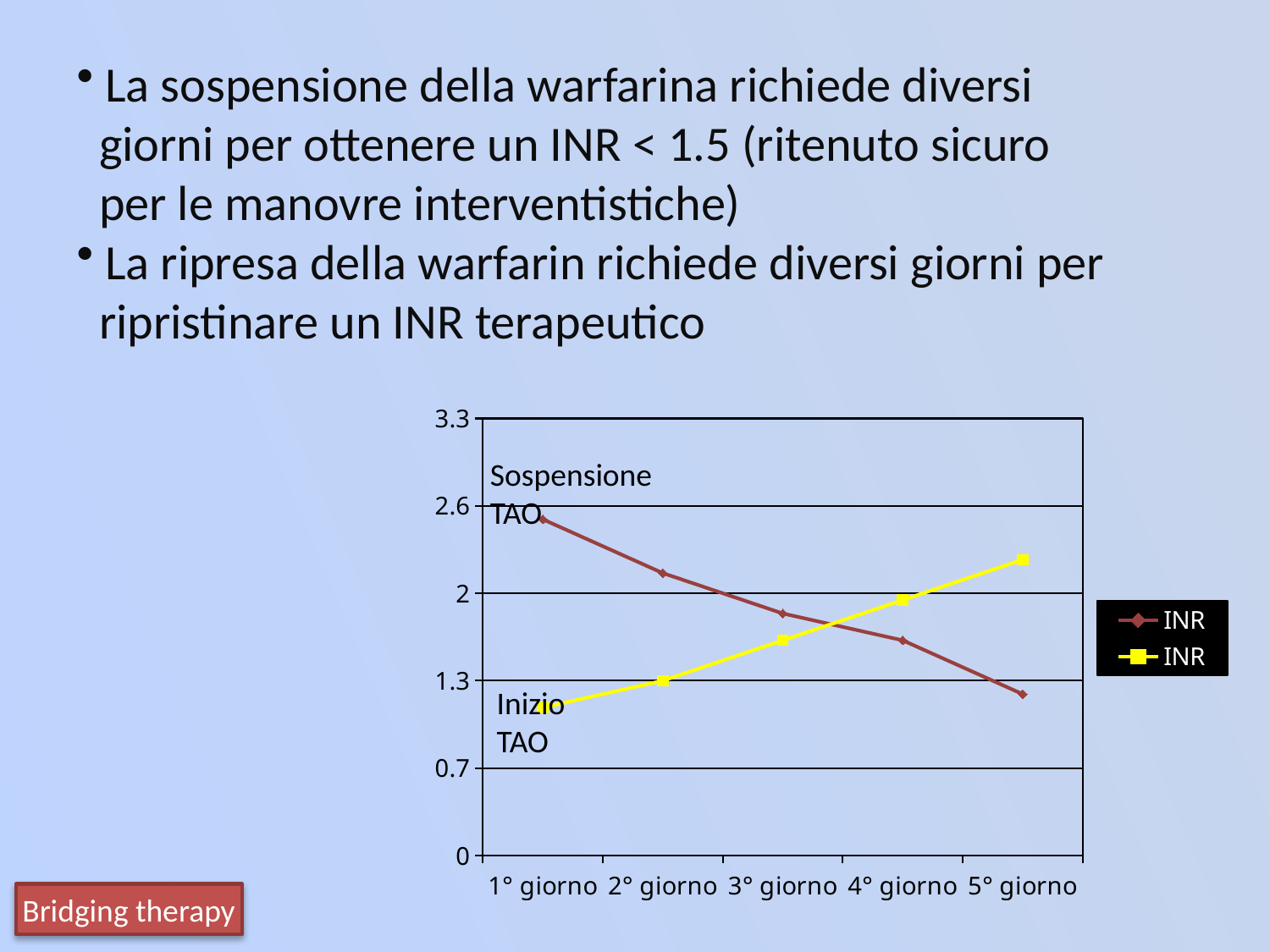
How many series does the chart legend list? 2 Does the dark red line (Sospensione TAO) rise or fall from 1° giorno to 5° giorno? fall At 5° giorno, which line has the higher value, the dark red line or the yellow line? the yellow line How many days (points) are shown along the x axis of the chart? 5 What kind of chart is shown on the slide? line chart Is the value of the dark red line (Sospensione TAO) at 1° giorno greater or less than 2? greater Is the value of the yellow line (Inizio TAO) at 5° giorno greater or less than 2? greater At 1° giorno, which line has the higher value, the dark red line or the yellow line? the dark red line On which day does the dark red line (Sospensione TAO) reach its lowest value? 5° giorno Is the value of the dark red line (Sospensione TAO) at 5° giorno greater or less than 2? less Does the yellow line (Inizio TAO) rise or fall from 1° giorno to 5° giorno? rise